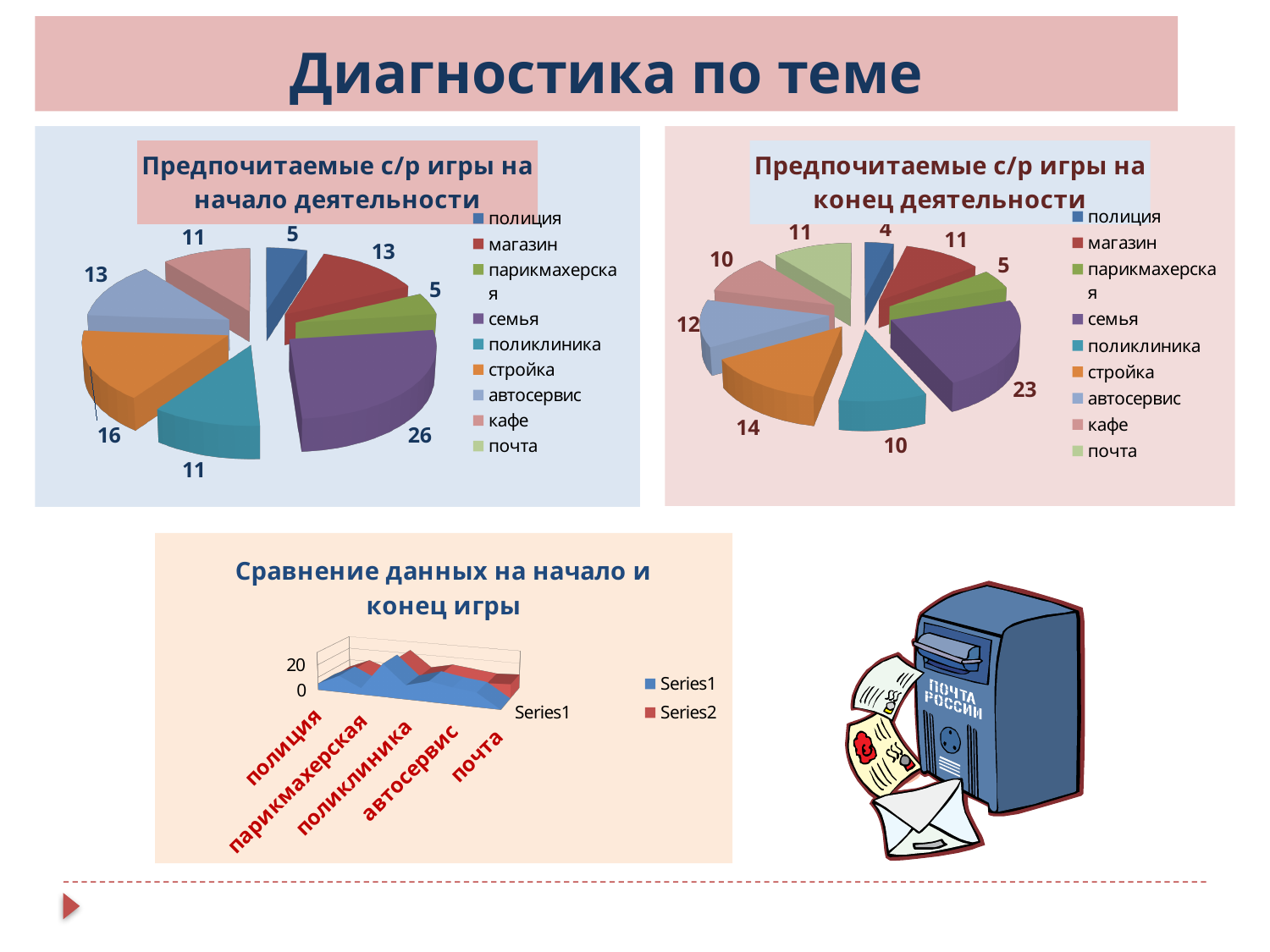
In the pie chart 'Предпочитаемые с/р игры на начало деятельности', what is the value for семья? 26 In the pie chart 'Предпочитаемые с/р игры на конец деятельности', what is the value for почта? 11 In the pie chart 'Предпочитаемые с/р игры на конец деятельности', what is the value for стройка? 14 In the pie chart 'Предпочитаемые с/р игры на начало деятельности', what is the value for полиция? 5 In the pie chart 'Предпочитаемые с/р игры на конец деятельности', what share of the total does семья represent? 23% In the pie chart 'Предпочитаемые с/р игры на конец деятельности', what is the difference between семья and магазин? 12 In the pie chart 'Предпочитаемые с/р игры на конец деятельности', which category has the smallest slice? полиция How many entries does the legend of the pie chart 'Предпочитаемые с/р игры на начало деятельности' list? 9 In the pie chart 'Предпочитаемые с/р игры на начало деятельности', which category has the largest slice? семья In the pie chart 'Предпочитаемые с/р игры на начало деятельности', which is larger: стройка or поликлиника? стройка What kind of chart is 'Сравнение данных на начало и конец игры' at the bottom of the slide? area chart How many series does the legend of the chart 'Сравнение данных на начало и конец игры' list? 2